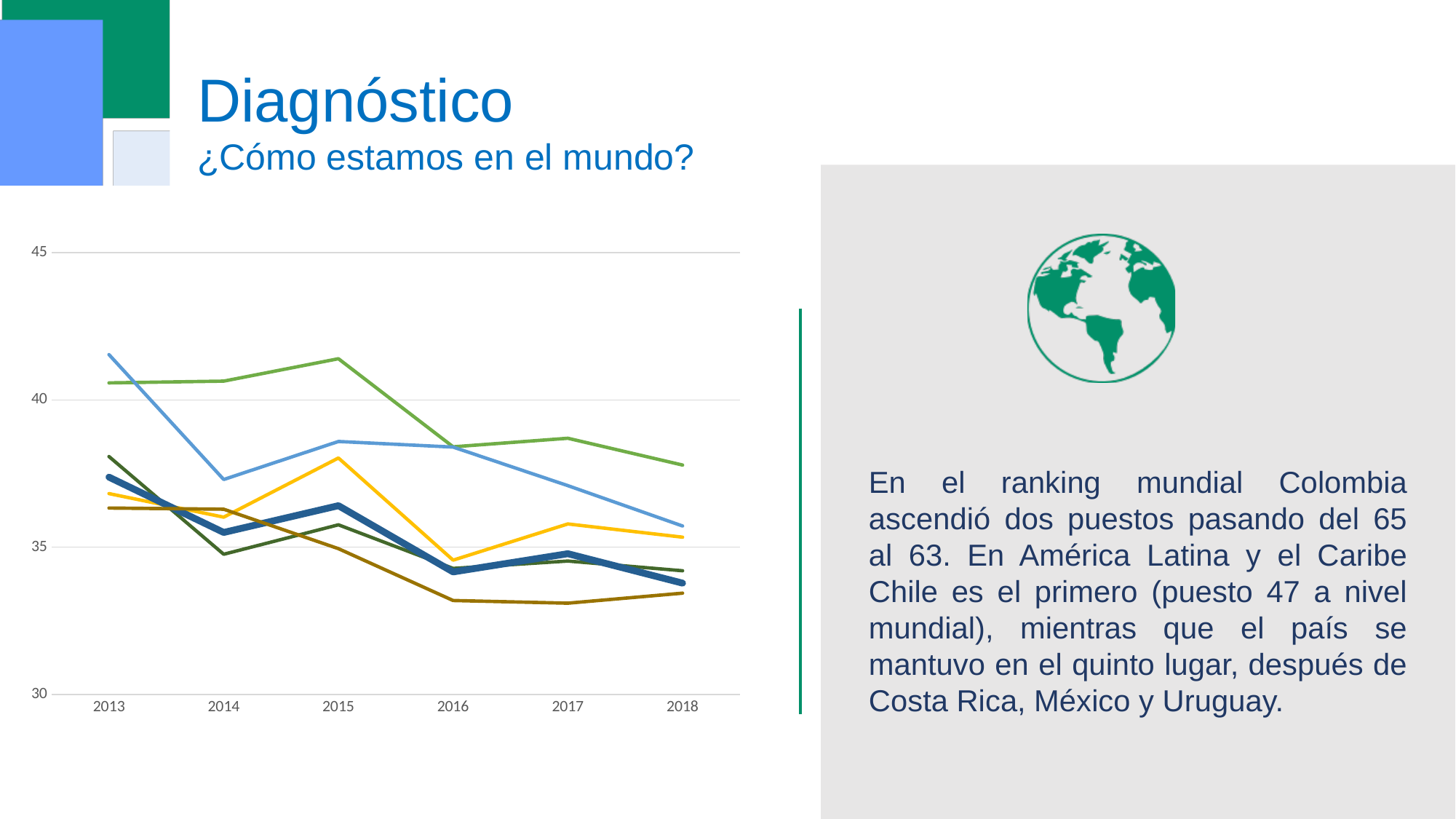
Is the value of the thick dark blue line in 2018 greater or less than 35? less What is the first year shown on the x axis of the chart? 2013 Is the value of the light blue line in 2013 greater or less than 40? greater Is the value of the yellow line in 2015 greater or less than 35? greater How many lines are plotted in the chart? 6 Which line has the highest value in 2018? the light green line What kind of chart is shown on the slide? line chart How many years are shown along the x axis of the chart? 6 Does the light blue line rise or fall overall from 2013 to 2018? fall Which line has the highest value in 2013? the light blue line